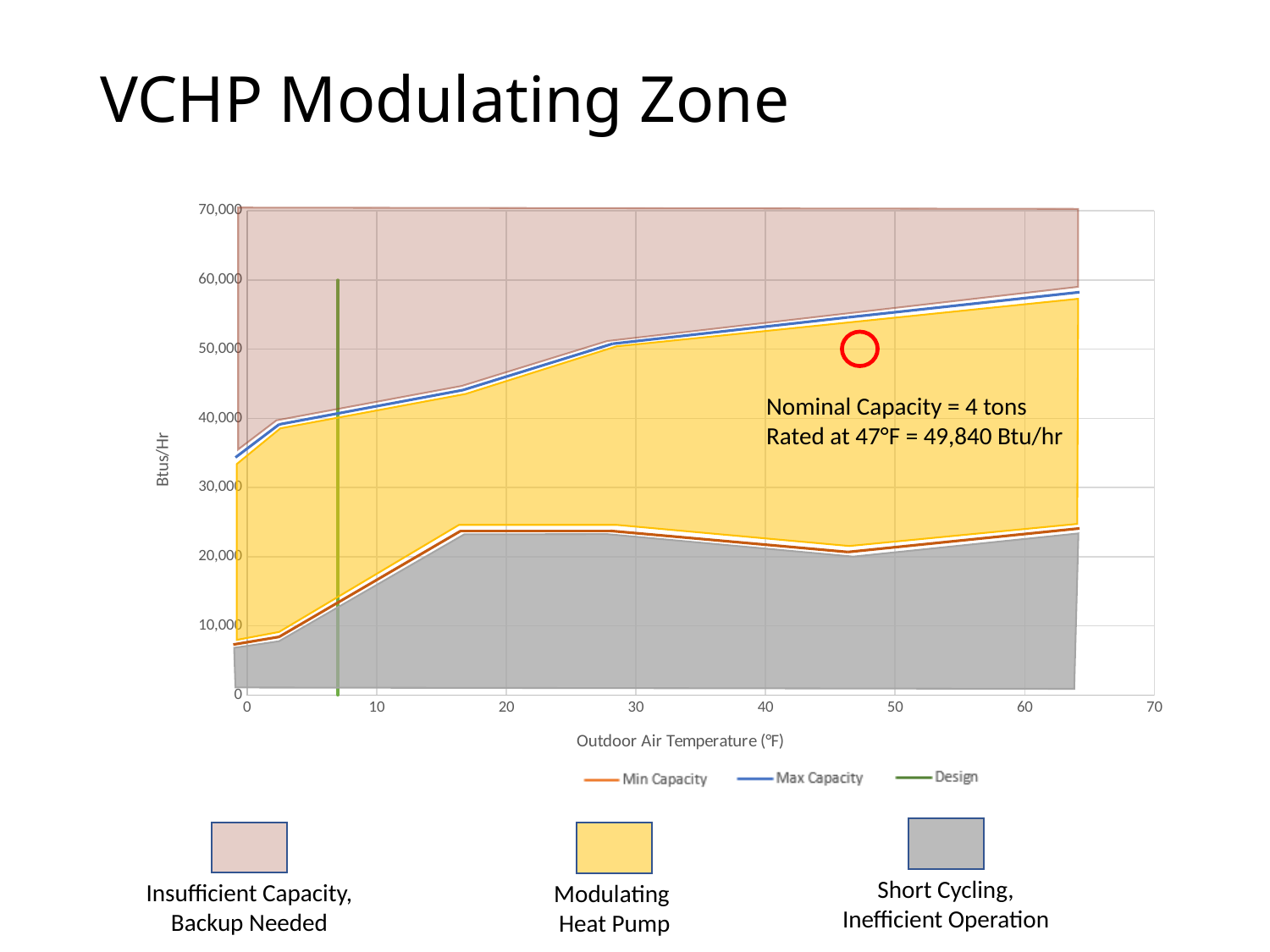
Is the Min Capacity value at 30°F greater or less than 30,000? less Does the Max Capacity line rise or fall as outdoor air temperature increases? rise How many series does the chart legend list? 3 Is the Max Capacity value at 0°F greater or less than 30,000? greater Is the Min Capacity value at 0°F greater or less than 10,000? less What is the title of the chart's x axis? Outdoor Air Temperature (°F) What kind of chart is shown on the slide? line chart What is the title of the chart's y axis? Btus/Hr According to the annotation on the chart, what is the rated capacity at 47°F? 49,840 Btu/hr At 40°F, which is larger: Max Capacity or Min Capacity? Max Capacity